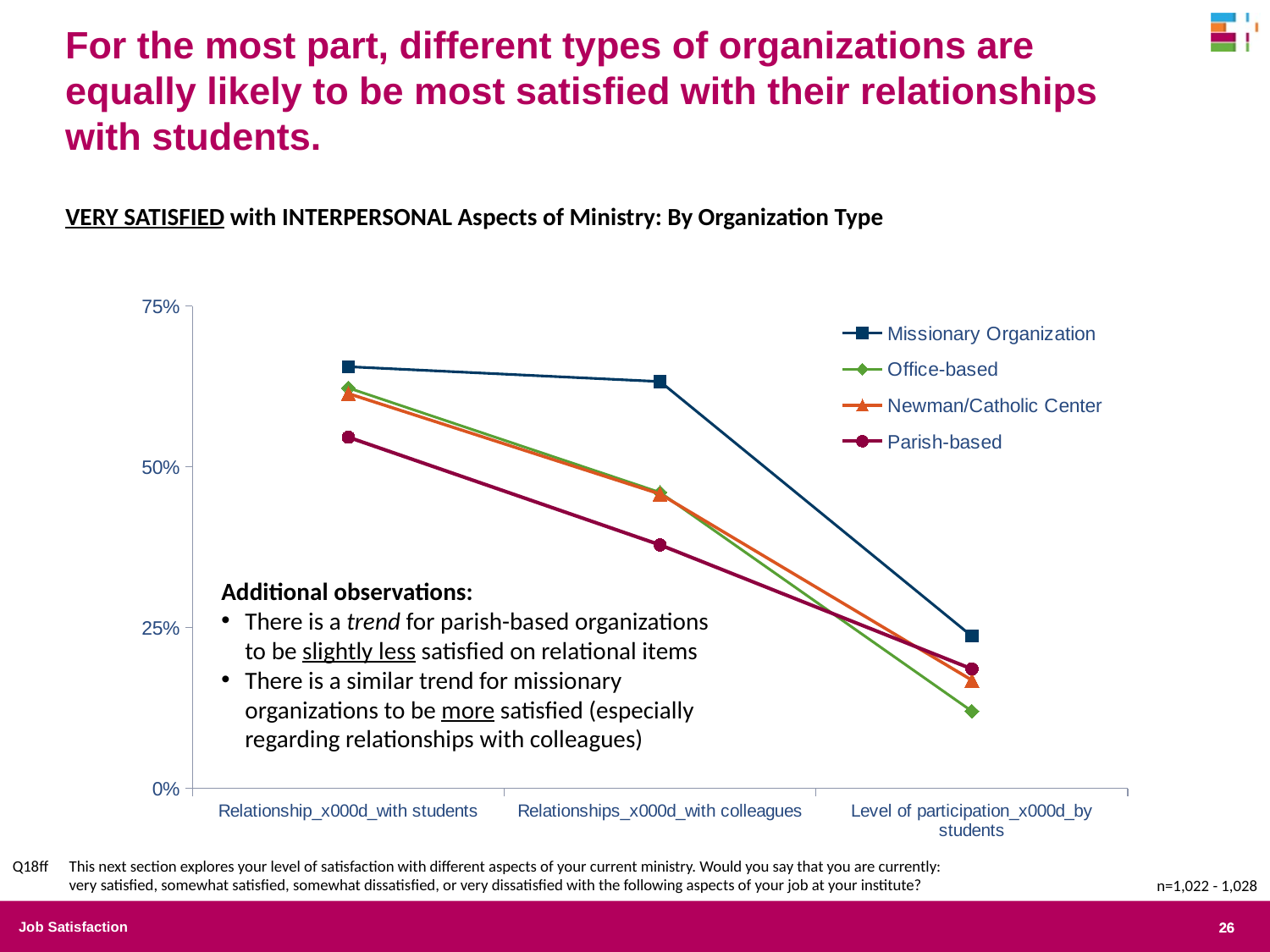
Do the values for Missionary Organization rise or fall from Relationship with students to Level of participation by students? fall For Relationships with colleagues, which is larger: Missionary Organization or Parish-based? Missionary Organization Which organization type has the lowest value for Relationship with students? Parish-based What kind of chart is shown on the slide? line chart Is the value for Office-based on Level of participation by students greater or less than 25%? less How many categories are shown on the x axis? 3 How many series does the legend list? 4 Is the value for Missionary Organization on Relationship with students greater or less than 50%? greater Which organization type has the lowest value for Level of participation by students? Office-based Which organization type has the highest value for Relationships with colleagues? Missionary Organization Which organization type has the highest value for Level of participation by students? Missionary Organization Is the value for Parish-based on Relationships with colleagues greater or less than 50%? less